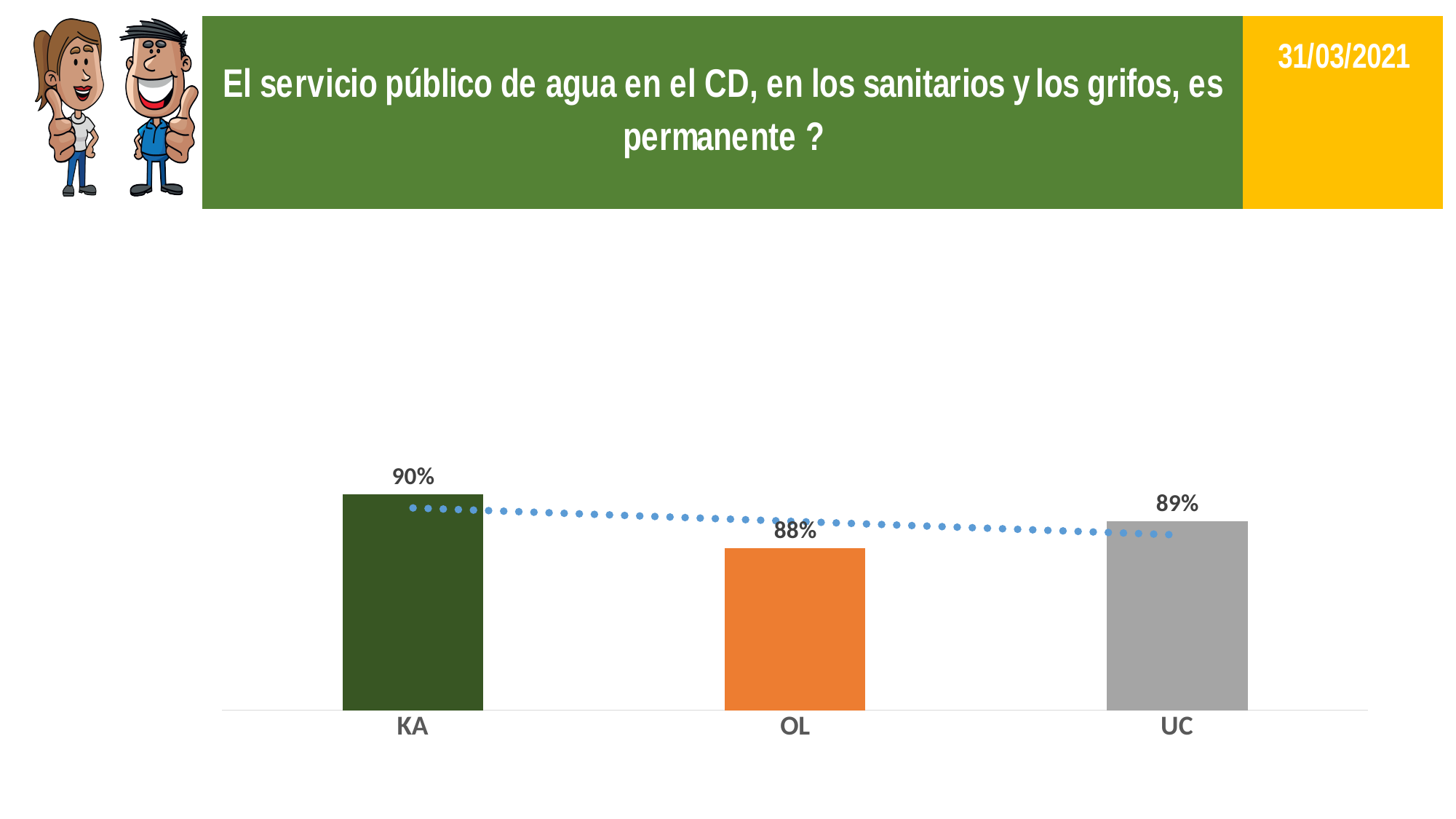
Which category has the highest value? KA What is the difference between the values for KA and OL? 2% Which is larger, the value for KA or the value for UC? KA Which is larger, the value for OL or the value for UC? UC What is the value for OL? 88% How many categories are shown in the chart? 3 Which category has the lowest value? OL What is the difference between the values for UC and OL? 1% What is the value for UC? 89% What kind of chart is shown on the slide? Bar chart What colour is the bar for OL? Orange What is the value for KA? 90%